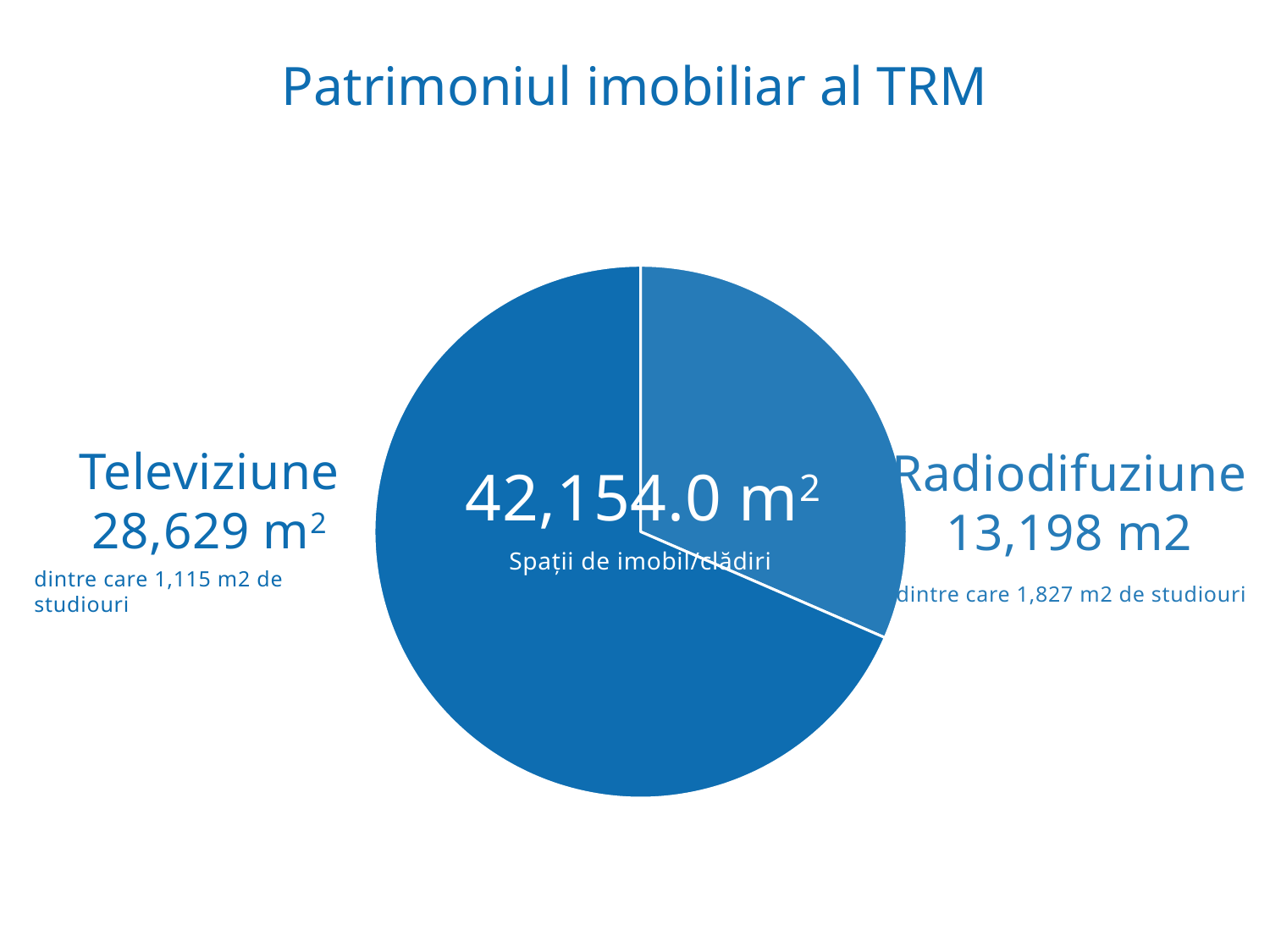
Which is larger, the value for Televiziune or the value for Radiodifuziune? Televiziune What is the value shown for Televiziune? 28,629 m² What is the value shown for Radiodifuziune? 13,198 m2 What kind of chart is shown on the slide? pie chart How many m2 of studios are included in the Radiodifuziune area? 1,827 m2 What is the title of the slide? Patrimoniul imobiliar al TRM How many m2 of studios are included in the Televiziune area? 1,115 m2 What total value is printed in the centre of the pie chart? 42,154.0 m² Which category has the largest slice of the pie? Televiziune What is the difference between the Televiziune value and the Radiodifuziune value? 15,431 m² Which category has the smallest slice of the pie? Radiodifuziune How many slices does the pie chart have? 2